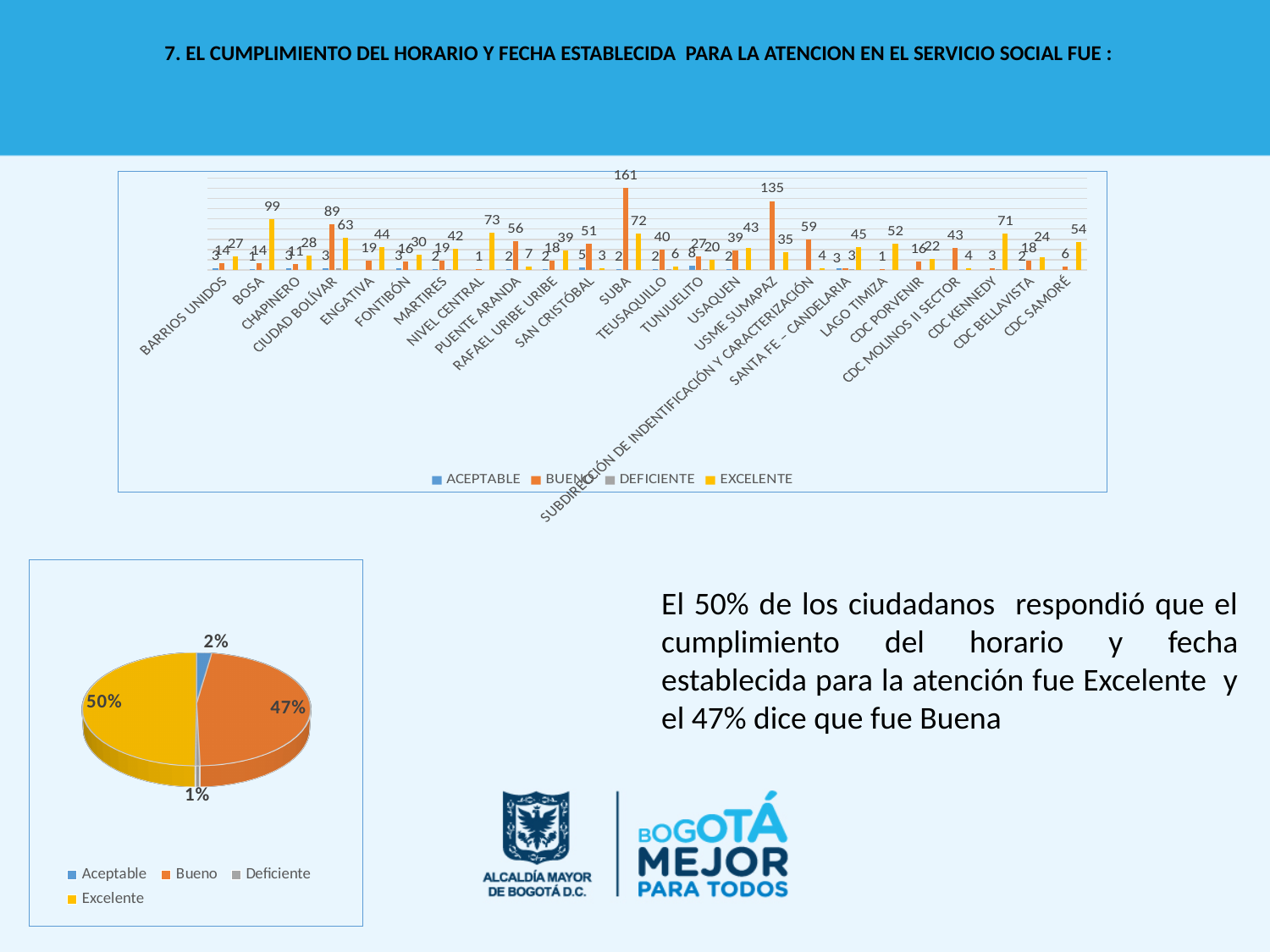
In the pie chart, what is the difference in percentage points between Excelente and Bueno? 3% In the pie chart, what share of respondents answered Excelente? 50% In the pie chart, what share of respondents answered Aceptable? 2% What kind of chart is the chart at the bottom left of the slide? Pie chart In the pie chart, which category has the smallest slice? Deficiente In the pie chart, what share of respondents answered Bueno? 47% In the top bar chart, what is the BUENO value for USME SUMAPAZ? 135 In the top bar chart, which is larger: the BUENO value for SUBA or the BUENO value for USME SUMAPAZ? SUBA In the pie chart, which category has the largest slice? Excelente How many series does the legend of the top chart list? 4 In the top bar chart, what is the BUENO value for SUBA? 161